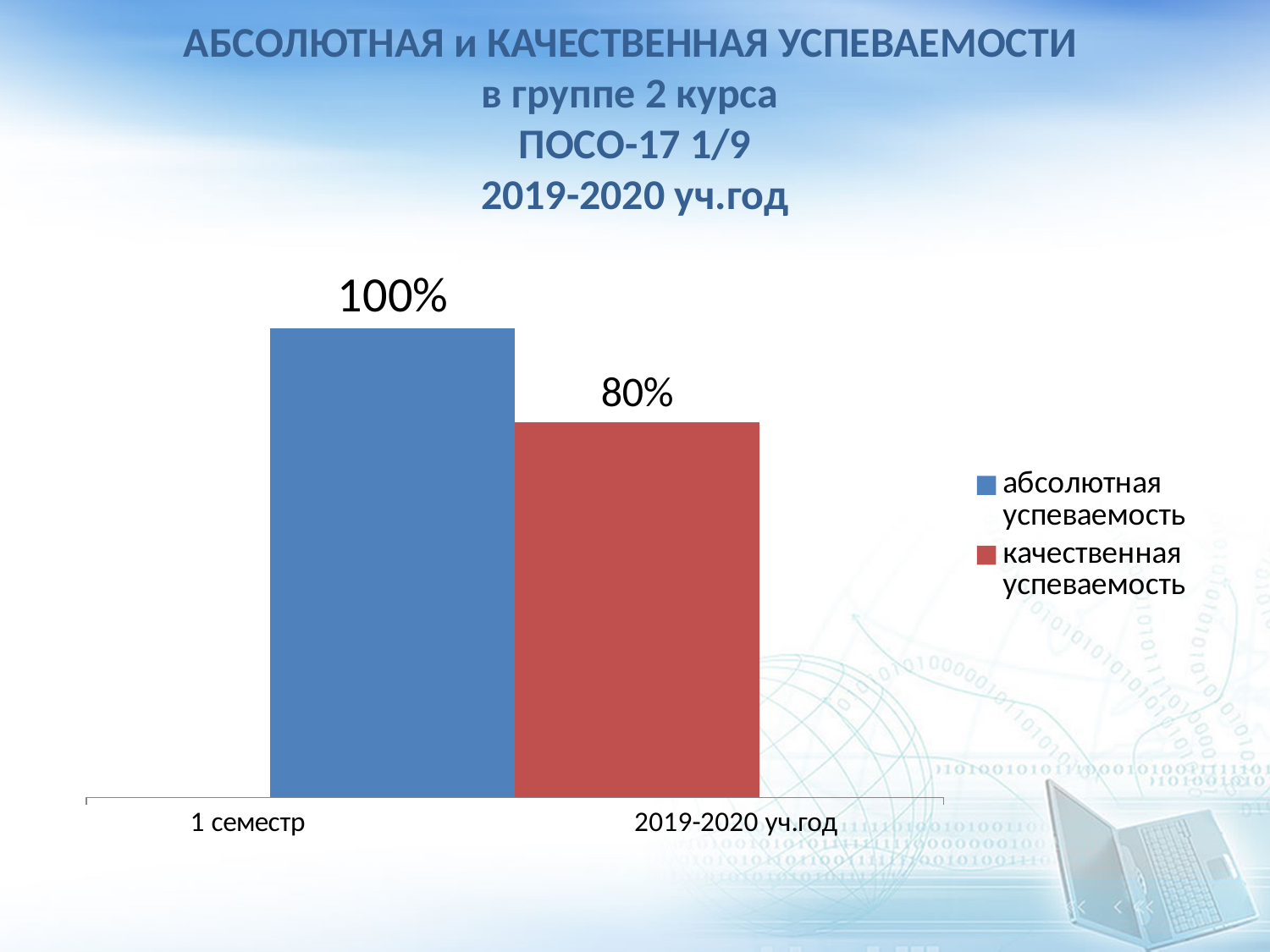
How many series does the legend list? 2 Which series has the lowest value? качественная успеваемость What colour is the bar for качественная успеваемость? red What is the value for абсолютная успеваемость? 100% Which series has the highest value? абсолютная успеваемость What is the value for качественная успеваемость? 80% What colour is the bar for абсолютная успеваемость? blue What is the total of the two values shown on the chart? 180% Which is larger, абсолютная успеваемость or качественная успеваемость? абсолютная успеваемость What kind of chart is shown on the slide? bar chart What is the difference between абсолютная успеваемость and качественная успеваемость? 20%